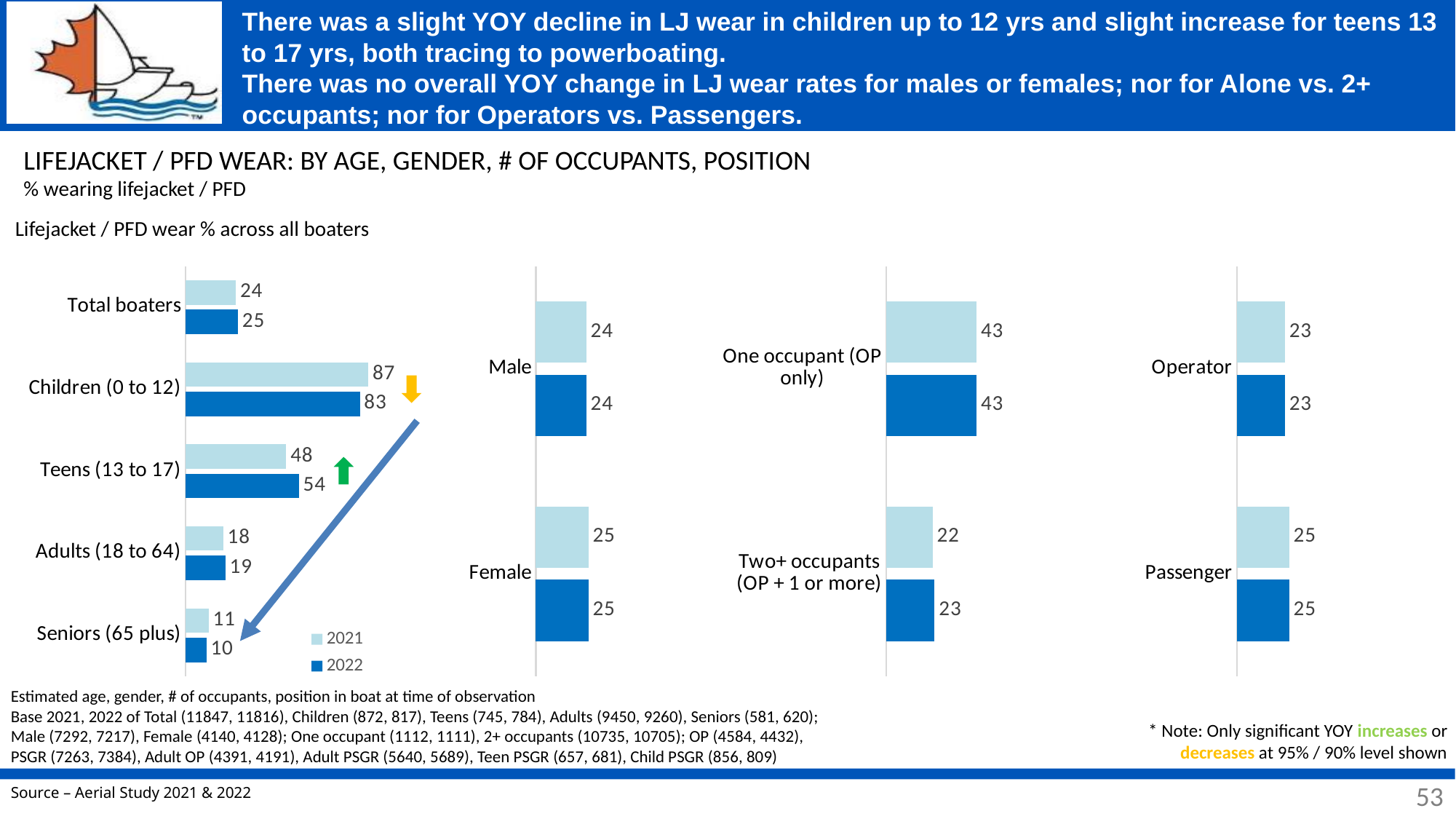
In the leftmost age chart, which age category has the lowest 2022 value? Seniors (65 plus) In the occupants chart, what is the 2021 value for One occupant (OP only)? 43 How many series does the legend of the leftmost age chart list? 2 In the gender chart, what is the 2022 value for Female? 25 In the leftmost age chart, what is the 2021 value for Teens (13 to 17)? 48 How many categories are shown in the leftmost age chart? 5 In the leftmost age chart, which age category has the highest 2021 value? Children (0 to 12) What type of chart is used for the age breakdown on the left of the slide? bar chart In the position chart, what is the 2022 value for Passenger? 25 In the leftmost age chart, is the 2022 value for Adults (18 to 64) higher or lower than the 2021 value? higher In the leftmost age chart, what is the 2022 value for Children (0 to 12)? 83 In the leftmost age chart, what is the difference between the 2021 and 2022 values for Teens (13 to 17)? 6